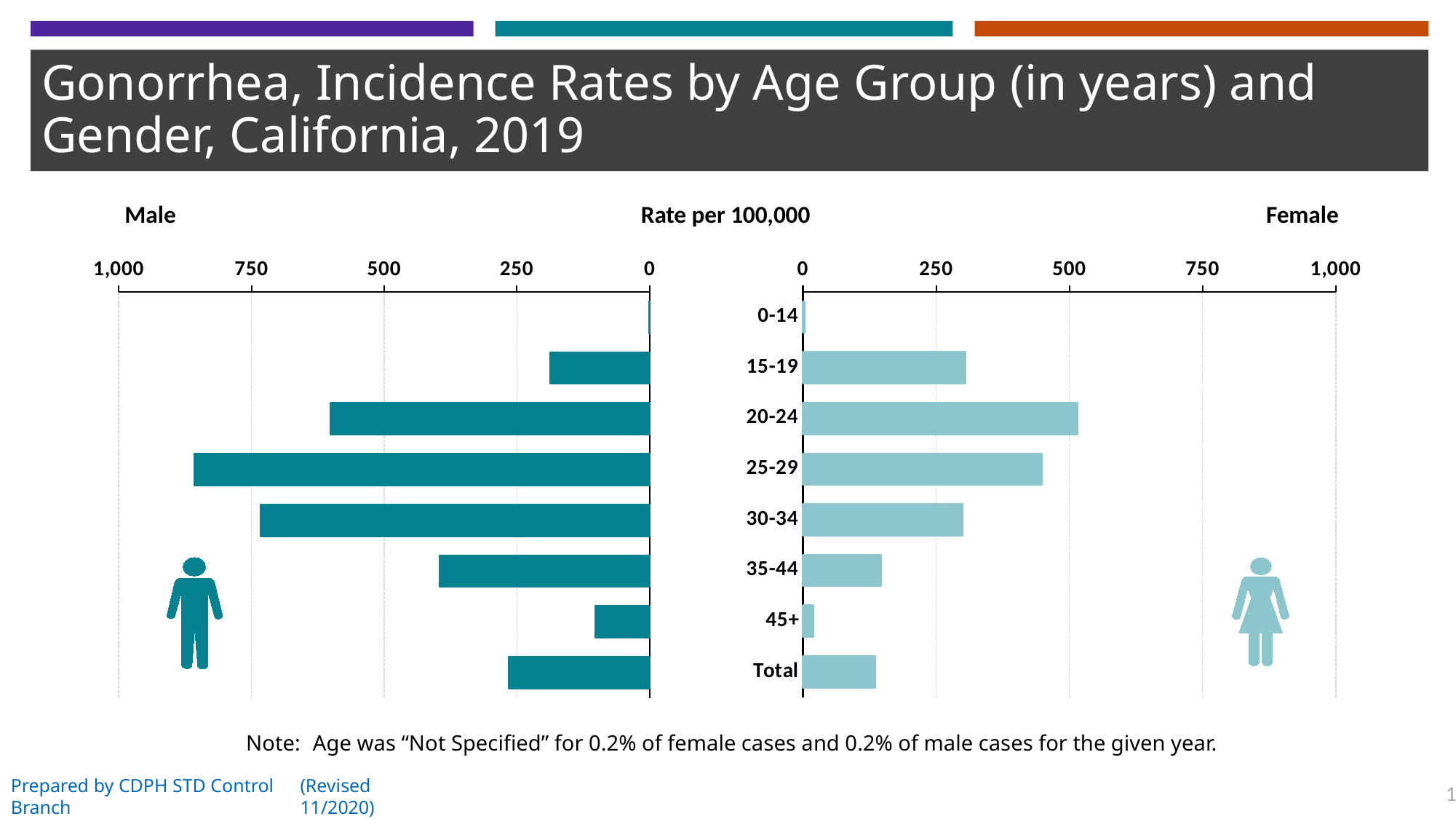
Is the male rate for the 25-29 age group greater or less than 750 per 100,000? greater Is the female rate for the 15-19 age group greater or less than 250 per 100,000? greater Which age group has the highest female gonorrhea incidence rate? 20-24 Which age group has the highest male gonorrhea incidence rate? 25-29 Is the male rate for the 20-24 age group greater or less than 500 per 100,000? greater For the 15-19 age group, is the male or the female rate higher? Female Which age group has the lowest female gonorrhea incidence rate? 0-14 For the 25-29 age group, is the male or the female rate higher? Male How many age-group categories (including Total) are shown on the chart? 8 What unit is the rate measured in, according to the axis label at the top of the chart? Rate per 100,000 What kind of chart is shown on the slide? bar chart